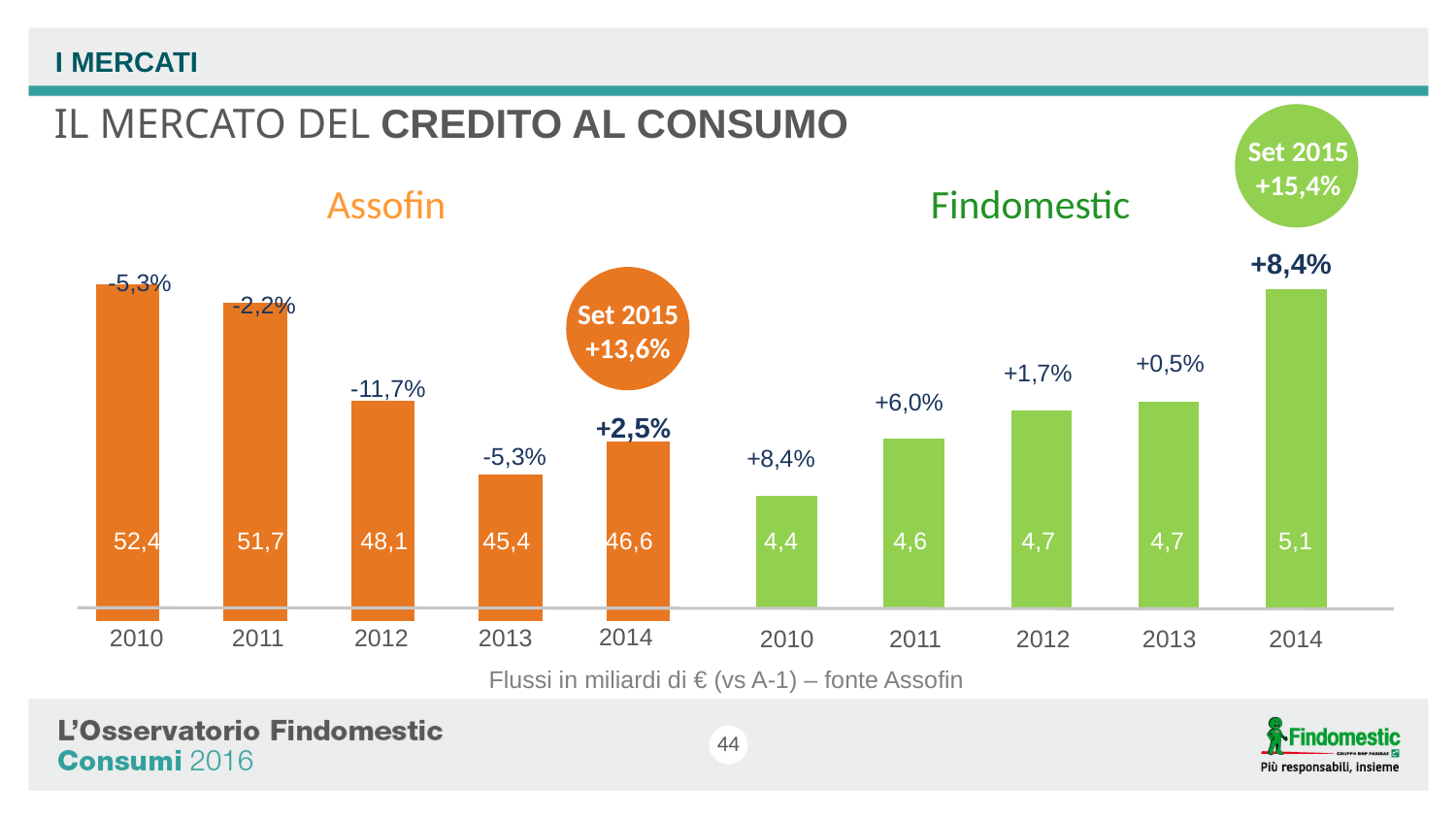
In the Assofin chart, what is the difference between the 2010 and 2014 values? 5,8 In the Findomestic chart, which year has the highest value? 2014 What growth figure is shown in the green circle labelled Set 2015 for Findomestic? +15,4% In the Findomestic chart, what is the value for 2014? 5,1 In the Assofin chart, what is the percentage change shown for 2012? -11,7% What kind of chart is used to show the Assofin and Findomestic data? Bar chart In the Findomestic chart, which is larger, the value for 2010 or the value for 2011? 2011 In the Assofin chart, what is the value for 2010? 52,4 In the Findomestic chart, what is the percentage change shown for 2011? +6,0% How many years are shown in the Assofin chart? 5 In the Assofin chart, which year has the lowest value? 2013 In the Findomestic chart, do the values rise or fall from 2010 to 2014? Rise